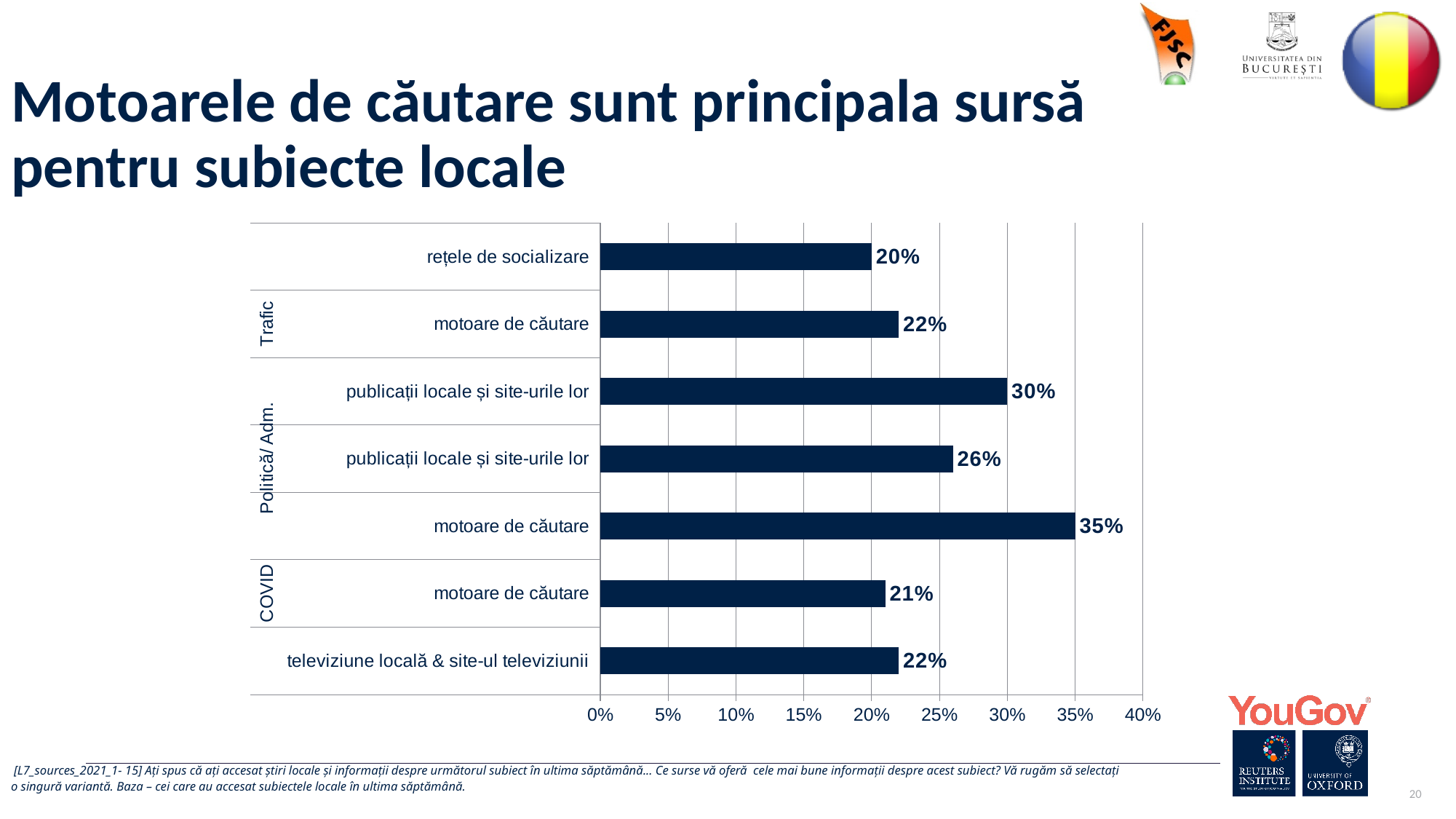
What is the title of the slide? Motoarele de căutare sunt principala sursă pentru subiecte locale Which bar has the highest value? motoare de căutare (Politică/Adm.), 35% Which is larger: the value for "rețele de socializare" or the value for "motoare de căutare" in the Trafic group? motoare de căutare (Trafic) What is the value for "motoare de căutare" in the Politică/Adm. group? 35% What is the difference between the highest bar (35%) and the 30% bar for "publicații locale și site-urile lor"? 5 percentage points What is the value for "rețele de socializare"? 20% How many bars are plotted in the chart? 7 Which bar has the lowest value? rețele de socializare, 20% What kind of chart is shown on the slide? bar chart What is the value for "motoare de căutare" in the COVID group? 21% Is the value for "motoare de căutare" in the Politică/Adm. group greater or less than 30%? greater What is the value for "televiziune locală & site-ul televiziunii"? 22%